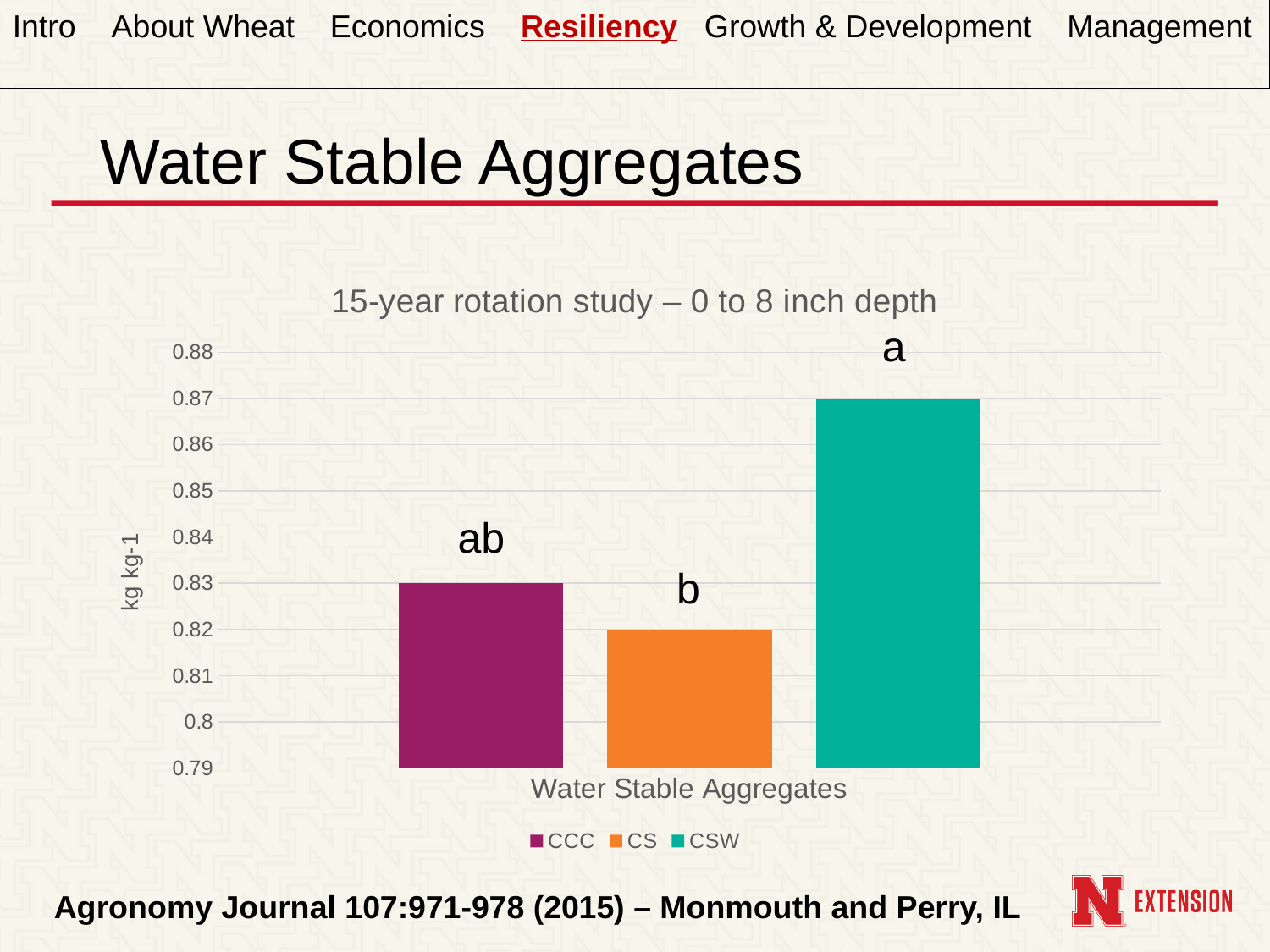
How many series does the legend list? 3 Which is larger, the value for CCC or the value for CSW? CSW What letter is printed above the CSW bar? a What is the chart's title? 15-year rotation study – 0 to 8 inch depth What kind of chart is shown on the slide? bar chart Which series has the highest water stable aggregates value? CSW What is the label on the vertical axis? kg kg-1 Is the value for CS greater or less than 0.83? less Is the value for CSW greater or less than 0.86? greater Which is larger, the value for CCC or the value for CS? CCC Which series has the lowest water stable aggregates value? CS Is the value for CCC greater or less than 0.85? less